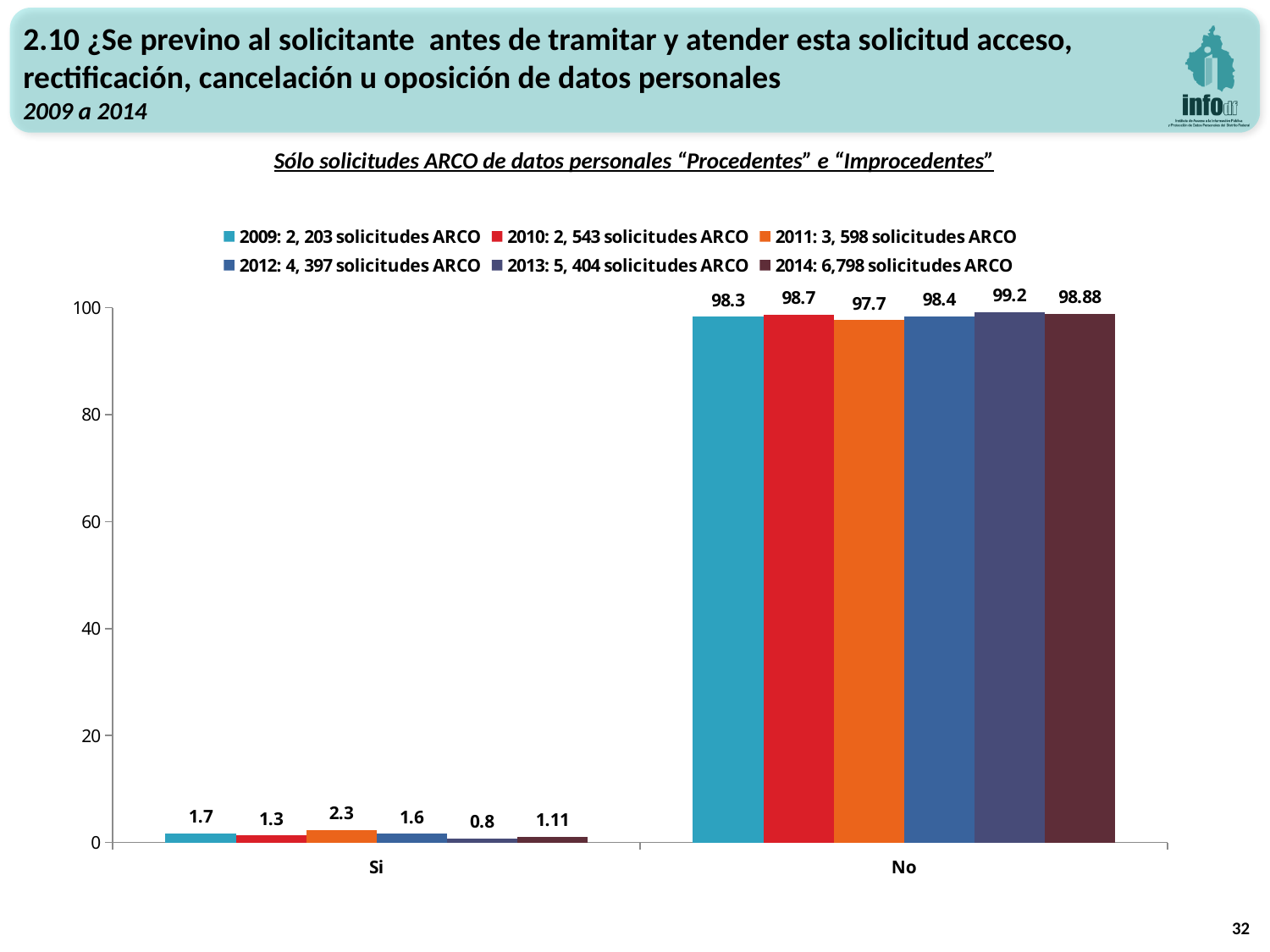
What is the value for 2009 in the "Si" category? 1.7 What is the value for 2011 in the "Si" category? 2.3 How many series does the legend list? 6 Which year has the lowest value in the "Si" category? 2013 Which is larger in the "No" category: the value for 2010 or the value for 2011? 2010 What is the difference between the 2011 and 2013 values in the "Si" category? 1.5 What is the value for 2014 in the "No" category? 98.88 According to the legend, how many solicitudes ARCO were there in 2014? 6,798 How many categories are shown on the x axis? 2 Which year has the highest value in the "No" category? 2013 Is the value for 2012 in the "No" category greater or less than 80? greater What kind of chart is shown on the slide? bar chart